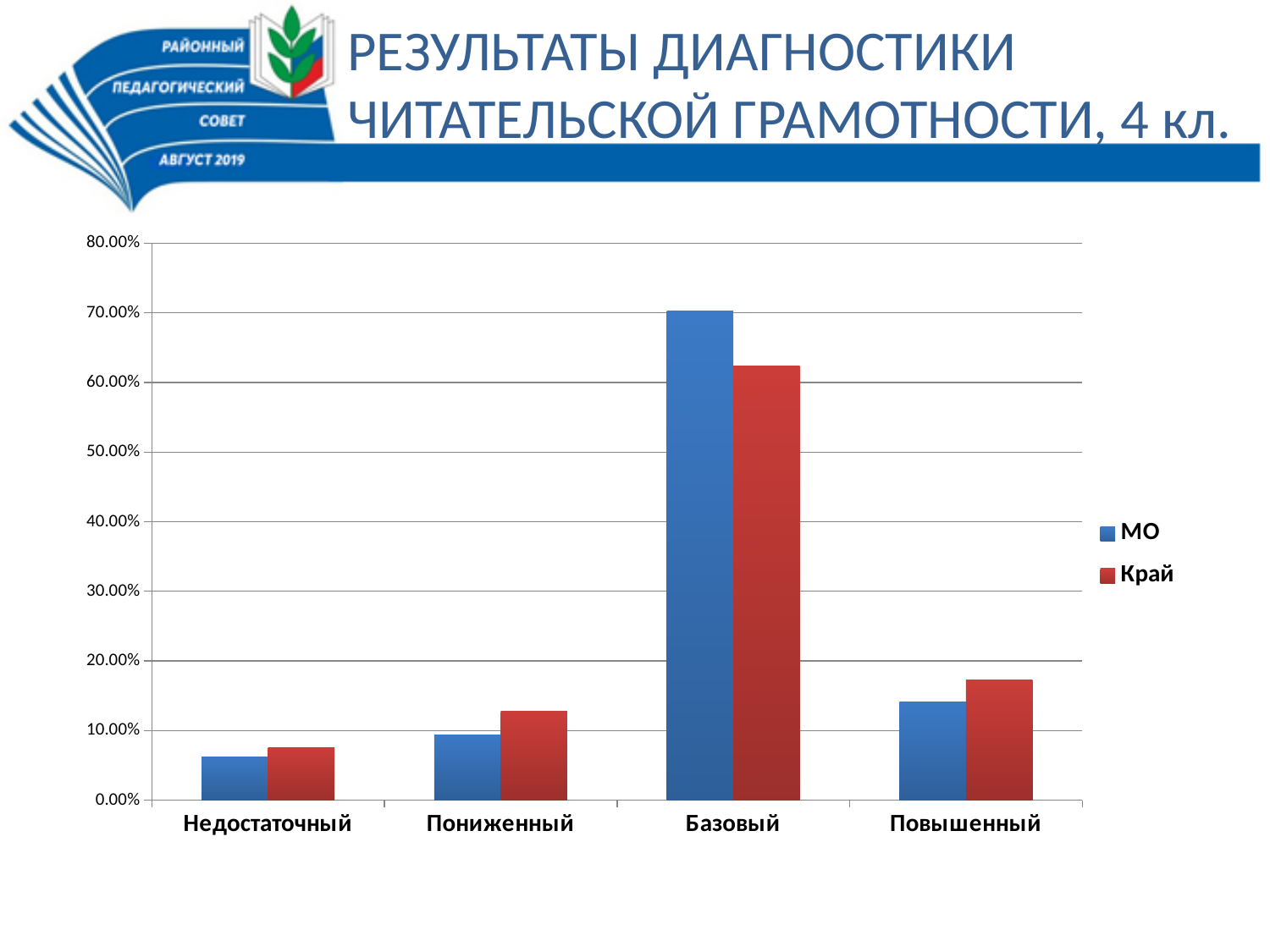
Which category has the highest value for the МО series? Базовый Which series is shown in red in the legend? Край Which category has the lowest value for the Край series? Недостаточный Is the Край value for Базовый greater or less than 70.00%? less How many categories are shown on the x axis? 4 Is the МО value for Пониженный greater or less than 10.00%? less How many series does the legend list? 2 What kind of chart is shown on the slide? bar chart Is the Край value for Повышенный greater or less than 20.00%? less For the Повышенный category, which series has the larger value, МО or Край? Край For the Базовый category, which series has the larger value, МО or Край? МО